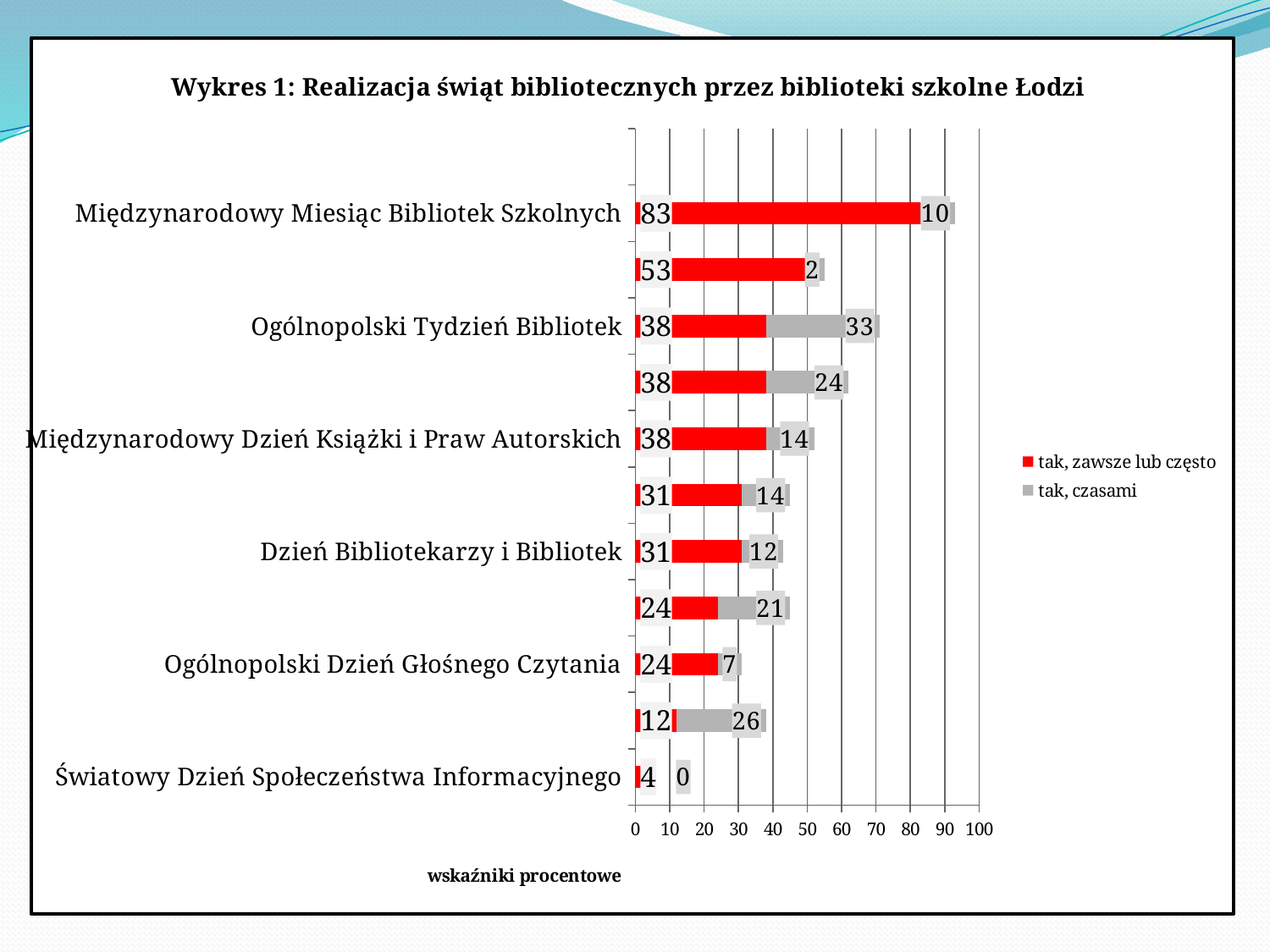
What type of chart is shown on the slide? Stacked bar chart What is the value of 'tak, zawsze lub często' for Międzynarodowy Miesiąc Bibliotek Szkolnych? 83 Which labelled category has the lowest value for 'tak, zawsze lub często'? Światowy Dzień Społeczeństwa Informacyjnego What is the total of the stacked bar for Międzynarodowy Miesiąc Bibliotek Szkolnych? 93 What is the value of 'tak, czasami' for Ogólnopolski Tydzień Bibliotek? 33 Which labelled category has the highest value for 'tak, zawsze lub często'? Międzynarodowy Miesiąc Bibliotek Szkolnych How many bars are plotted in the chart? 11 What is the value of 'tak, czasami' for Światowy Dzień Społeczeństwa Informacyjnego? 0 What is the x-axis label of the chart? wskaźniki procentowe What is the difference between the 'tak, czasami' values for Ogólnopolski Tydzień Bibliotek and Międzynarodowy Dzień Książki i Praw Autorskich? 19 What is the value of 'tak, zawsze lub często' for Dzień Bibliotekarzy i Bibliotek? 31 How many series does the legend list? 2